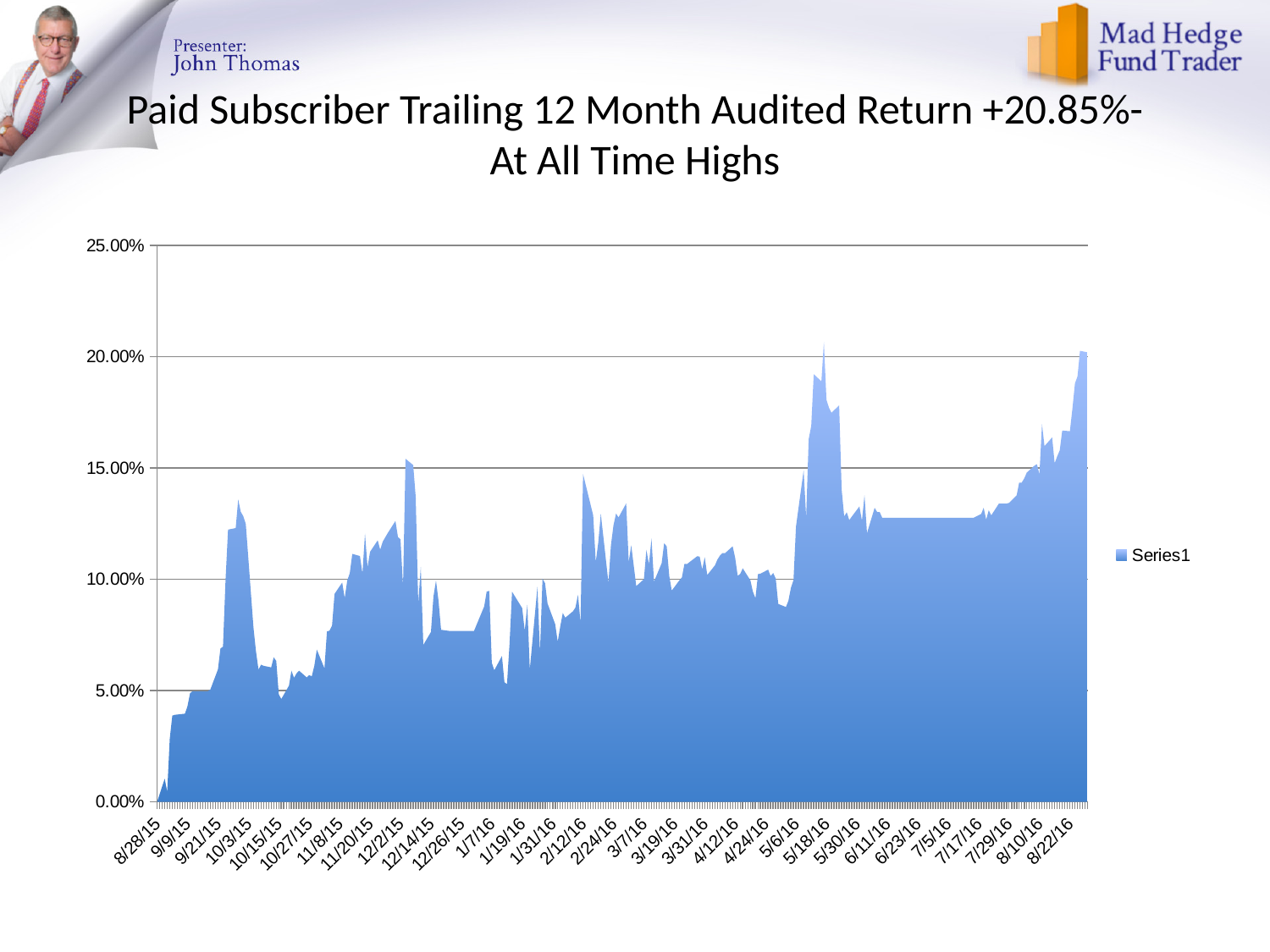
What is the highest value shown on the y axis? 25.00% What is the title of the slide above the chart? Paid Subscriber Trailing 12 Month Audited Return +20.85%- At All Time Highs Is the value around 10/15/15 greater or less than 10.00%? less Is the value around 6/11/16 greater or less than 10.00%? greater What is the name of the series shown in the legend? Series1 What kind of chart is shown on the slide? area chart How many series does the legend list? 1 Is the value around 1/19/16 greater or less than 10.00%? less Overall, do the values rise or fall from the start of the x axis (8/28/15) to the end (8/22/16)? rise